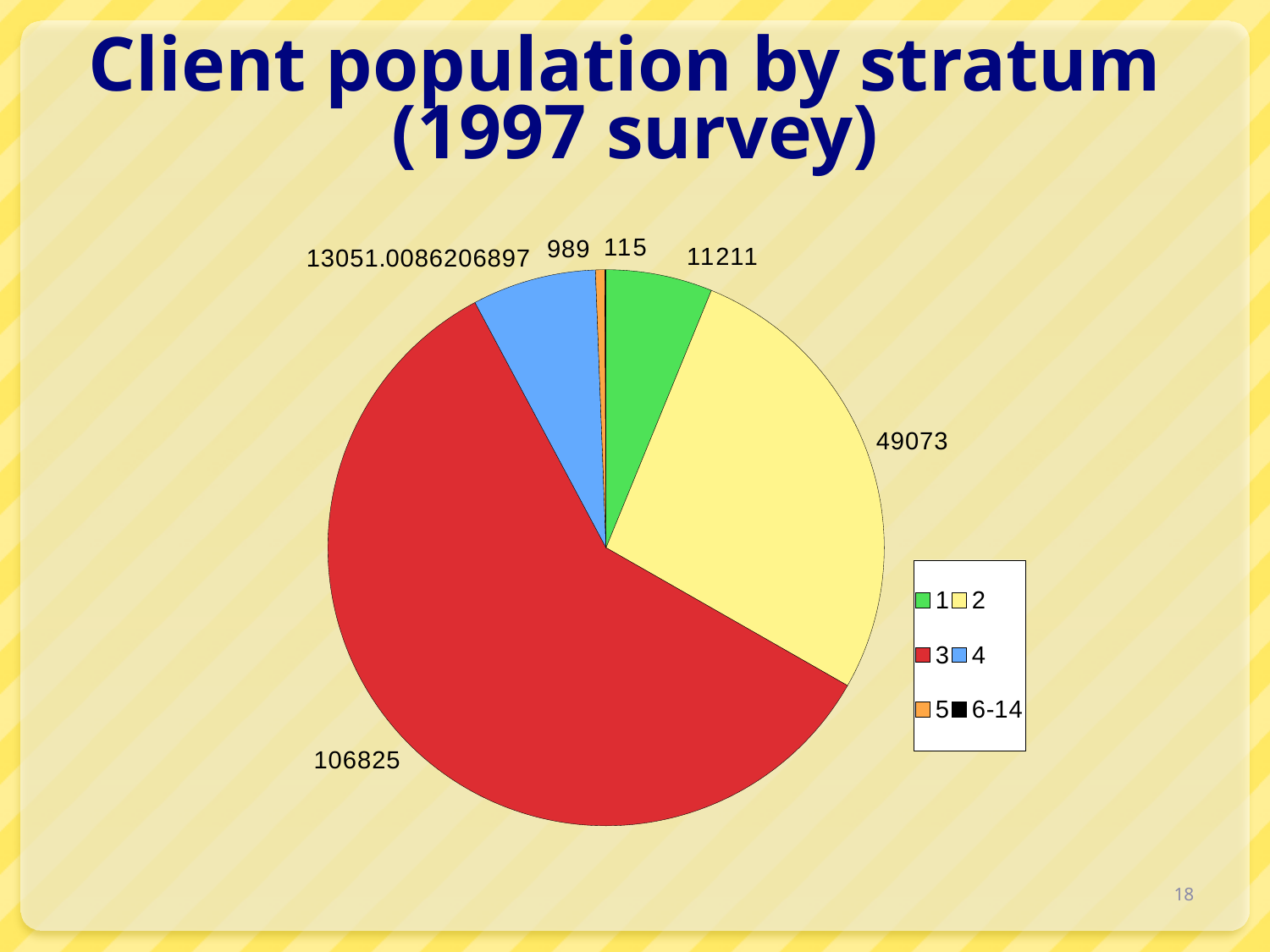
What is the value for stratum 3 in the pie chart? 106825 What is the difference between the values for stratum 3 and stratum 2? 57716 What is the title of the chart? Client population by stratum (1997 survey) Which is larger, the value for stratum 2 or the value for stratum 4? Stratum 2 What type of chart is shown on the slide? Pie chart How many categories does the legend list? 6 What is the value for stratum 5 in the pie chart? 989 Which stratum has the largest client population? 3 What is the value for stratum 1 in the pie chart? 11211 What is the value for stratum 2 in the pie chart? 49073 Which stratum has the smallest client population? 6-14 What is the value for stratum 6-14 in the pie chart? 115